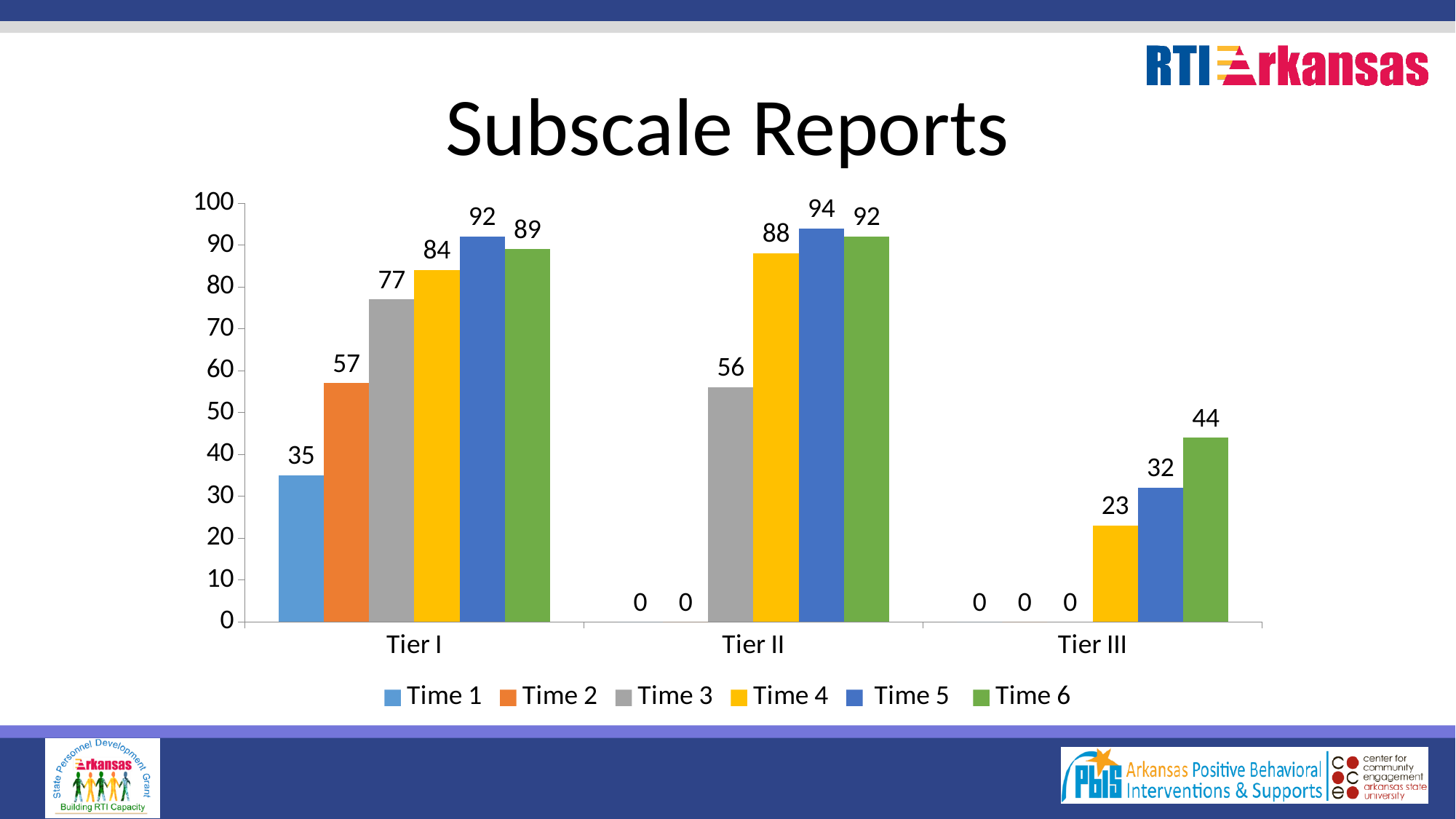
What is the value for Time 6 in Tier III? 44 Which is larger: the Time 4 value in Tier I or the Time 4 value in Tier II? Tier II Which series has the highest value in Tier I? Time 5 What is the difference between the Time 6 and Time 1 values in Tier I? 54 What kind of chart is shown on the slide? Bar chart What is the title of the slide? Subscale Reports How many series does the legend list? 6 Which series has the lowest non-zero value in Tier III? Time 4 What is the value for Time 1 in Tier I? 35 What is the value for Time 5 in Tier II? 94 What is the value for Time 3 in Tier II? 56 How many categories are shown on the x axis? 3